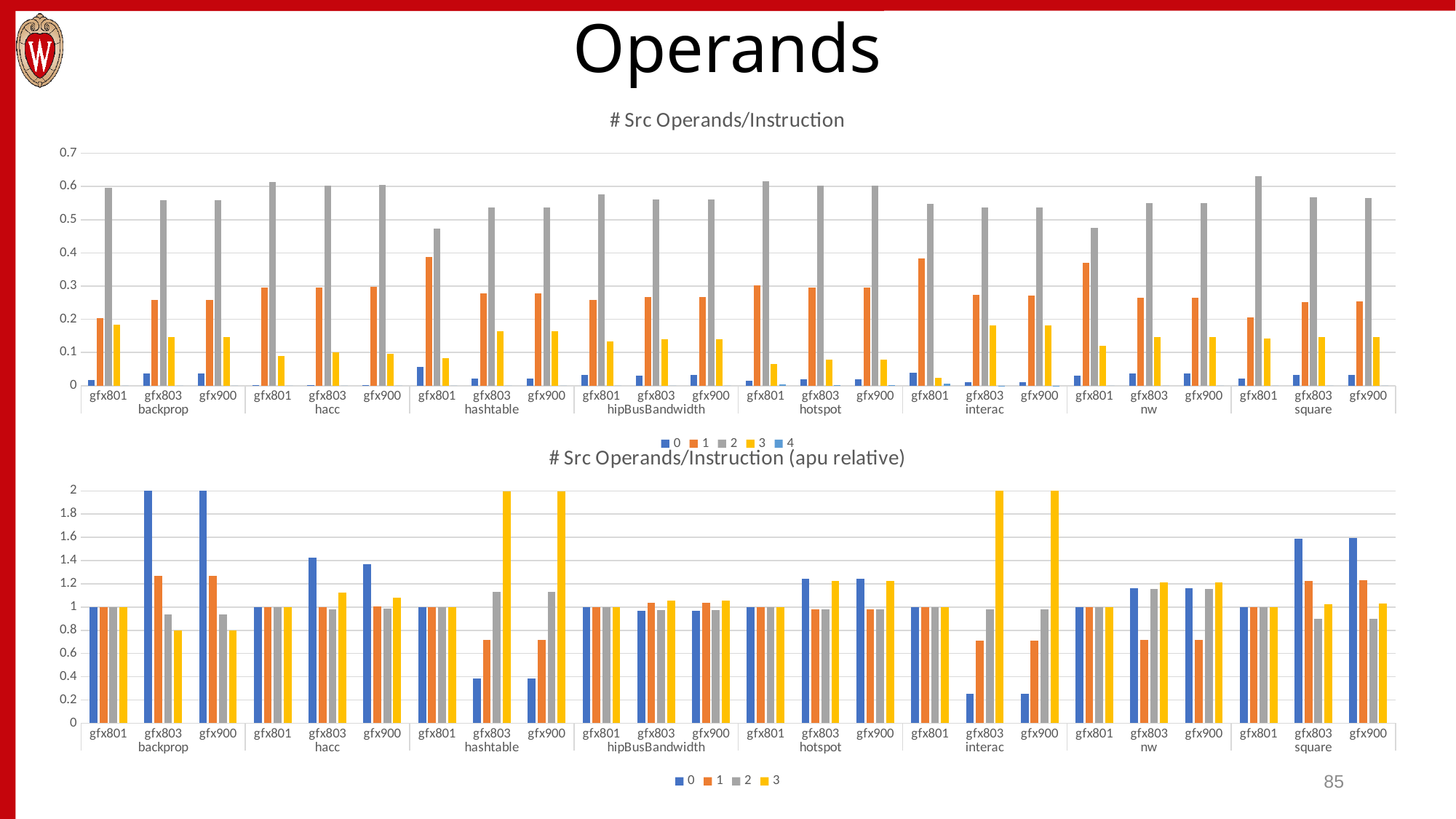
In the bottom chart ("# Src Operands/Instruction (apu relative)"), which is larger for gfx900 under backprop: series 0 or series 1? series 0 What kind of chart is the top chart titled "# Src Operands/Instruction"? bar chart In the top chart ("# Src Operands/Instruction"), is the value of series 1 for gfx801 under hashtable greater or less than 0.3? greater In the top chart ("# Src Operands/Instruction"), which is larger for gfx900 under hotspot: series 1 or series 2? series 2 How many series does the legend of the top chart ("# Src Operands/Instruction") list? 5 In the bottom chart ("# Src Operands/Instruction (apu relative)"), what is the value of series 0 for gfx801 under hacc? 1 In the bottom chart ("# Src Operands/Instruction (apu relative)"), is the value of series 0 for gfx803 under interac greater or less than 0.4? less In the top chart ("# Src Operands/Instruction"), is the value of series 2 for gfx801 under backprop greater or less than 0.5? greater How many benchmark groups are shown along the x axis of the bottom chart ("# Src Operands/Instruction (apu relative)")? 8 How many series does the legend of the bottom chart ("# Src Operands/Instruction (apu relative)") list? 4